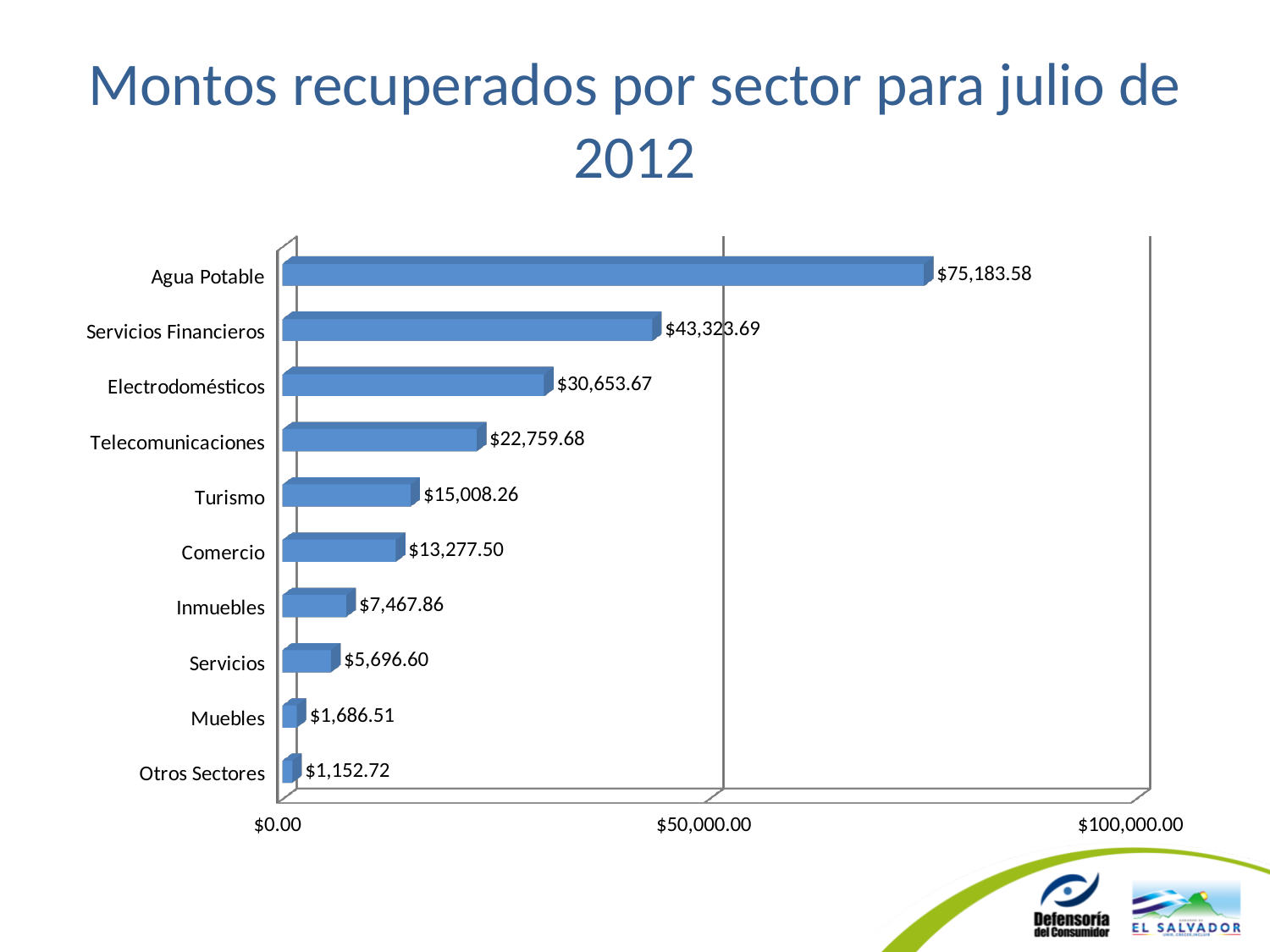
What is the difference between the values for Turismo and Comercio? $1,730.76 Which is larger, the value for Electrodomésticos or the value for Telecomunicaciones? Electrodomésticos What is the value for Telecomunicaciones? $22,759.68 What is the difference between the values for Agua Potable and Servicios Financieros? $31,859.89 What is the title of the chart? Montos recuperados por sector para julio de 2012 How many sectors are shown in the chart? 10 Is the value for Servicios Financieros greater or less than $50,000.00? less Which sector has the lowest recovered amount? Otros Sectores What is the value for Servicios? $5,696.60 Which sector has the highest recovered amount? Agua Potable What is the value for Agua Potable? $75,183.58 What kind of chart is shown on the slide? bar chart